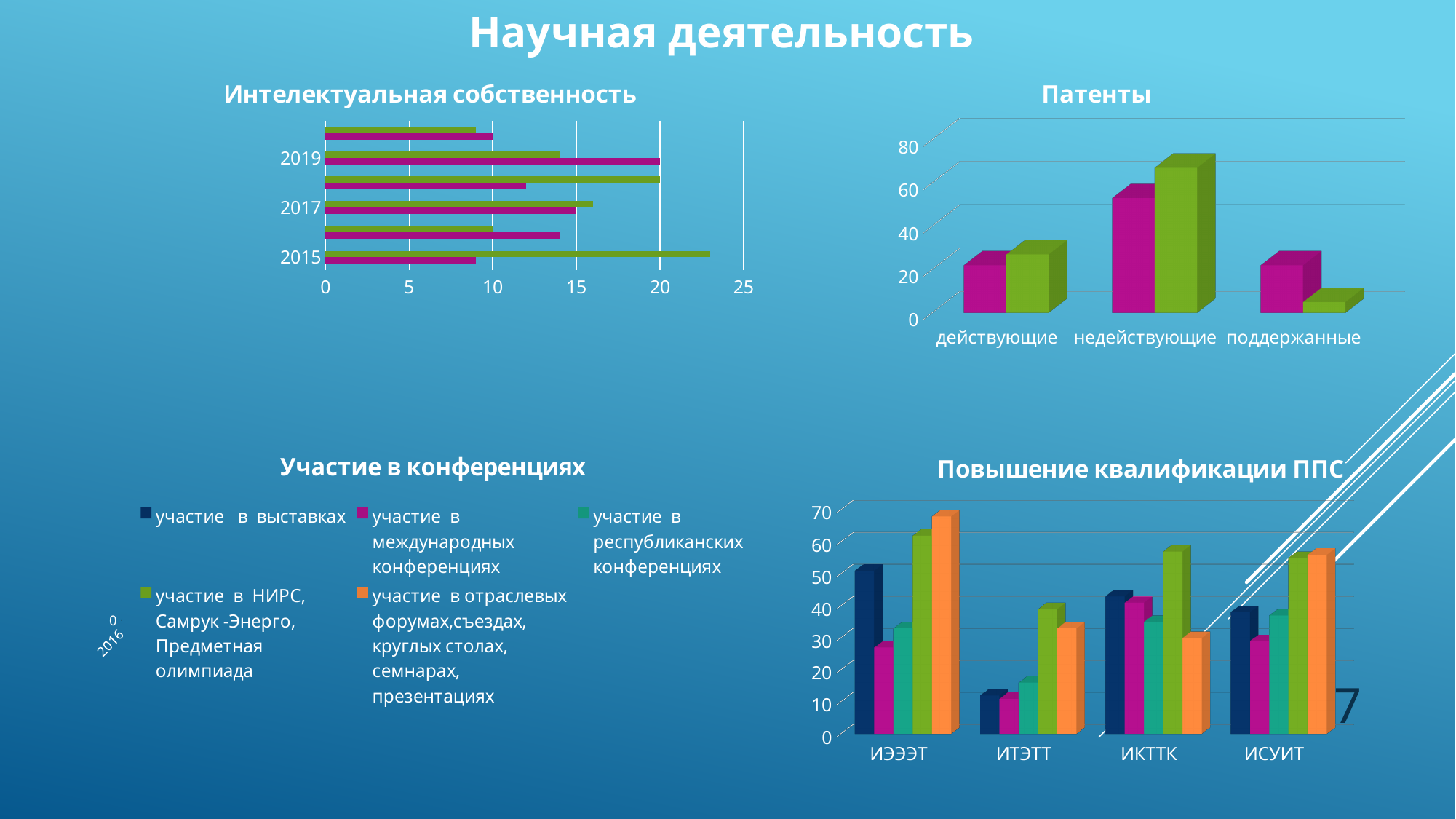
On the 'Интелектуальная собственность' chart, is the longest green bar for 2015 greater or less than 20? greater On the 'Патенты' chart, which category has the tallest bars? недействующие How many series does the legend of the 'Участие в конференциях' chart list? 5 On the 'Патенты' chart, which is larger for 'поддержанные': the magenta bar or the green bar? the magenta bar On the 'Интелектуальная собственность' chart, is the magenta bar for 2015 greater or less than 10? less What kind of chart is the 'Интелектуальная собственность' chart? bar chart On the 'Патенты' chart, is the green bar for 'недействующие' greater or less than 60? greater On the 'Интелектуальная собственность' chart, what is the highest value shown on the horizontal axis? 25 How many categories are shown on the horizontal axis of the 'Повышение квалификации ППС' chart? 4 How many categories are shown on the horizontal axis of the 'Патенты' chart? 3